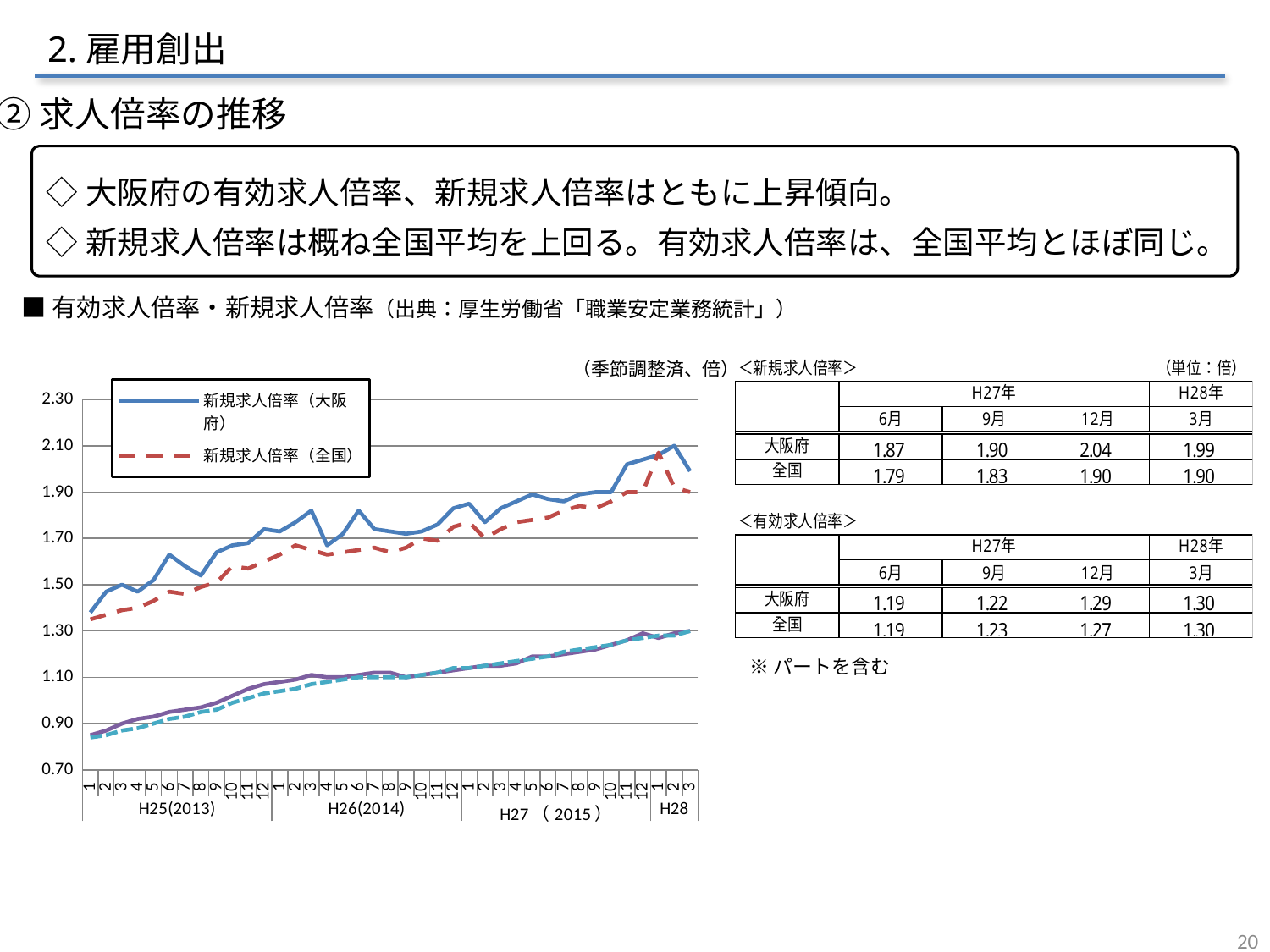
According to the 新規求人倍率 table, what is the difference between 大阪府 and 全国 in H27 12月? 0.14 Does the 新規求人倍率（大阪府） line generally rise or fall from H25 to H28? rise Is the value of 新規求人倍率（全国） at H25 month 1 greater or less than 1.50? less How many series does the chart's legend list? 2 How many monthly points are plotted along the x axis of the chart (H25 through H28)? 39 What kind of chart is shown on the slide? line chart According to the 新規求人倍率 table, what is the value for 大阪府 in H27 12月? 2.04 Is the value of 新規求人倍率（大阪府） at H25 month 1 greater or less than 1.50? less Is the value of 新規求人倍率（大阪府） at H28 month 3 greater or less than 1.90? greater At H25 month 1, which is higher: 新規求人倍率（大阪府） or 新規求人倍率（全国）? 新規求人倍率（大阪府） What are the two series named in the chart's legend? 新規求人倍率（大阪府）, 新規求人倍率（全国） At which month does the 新規求人倍率（大阪府） line reach its highest point? H28 2月